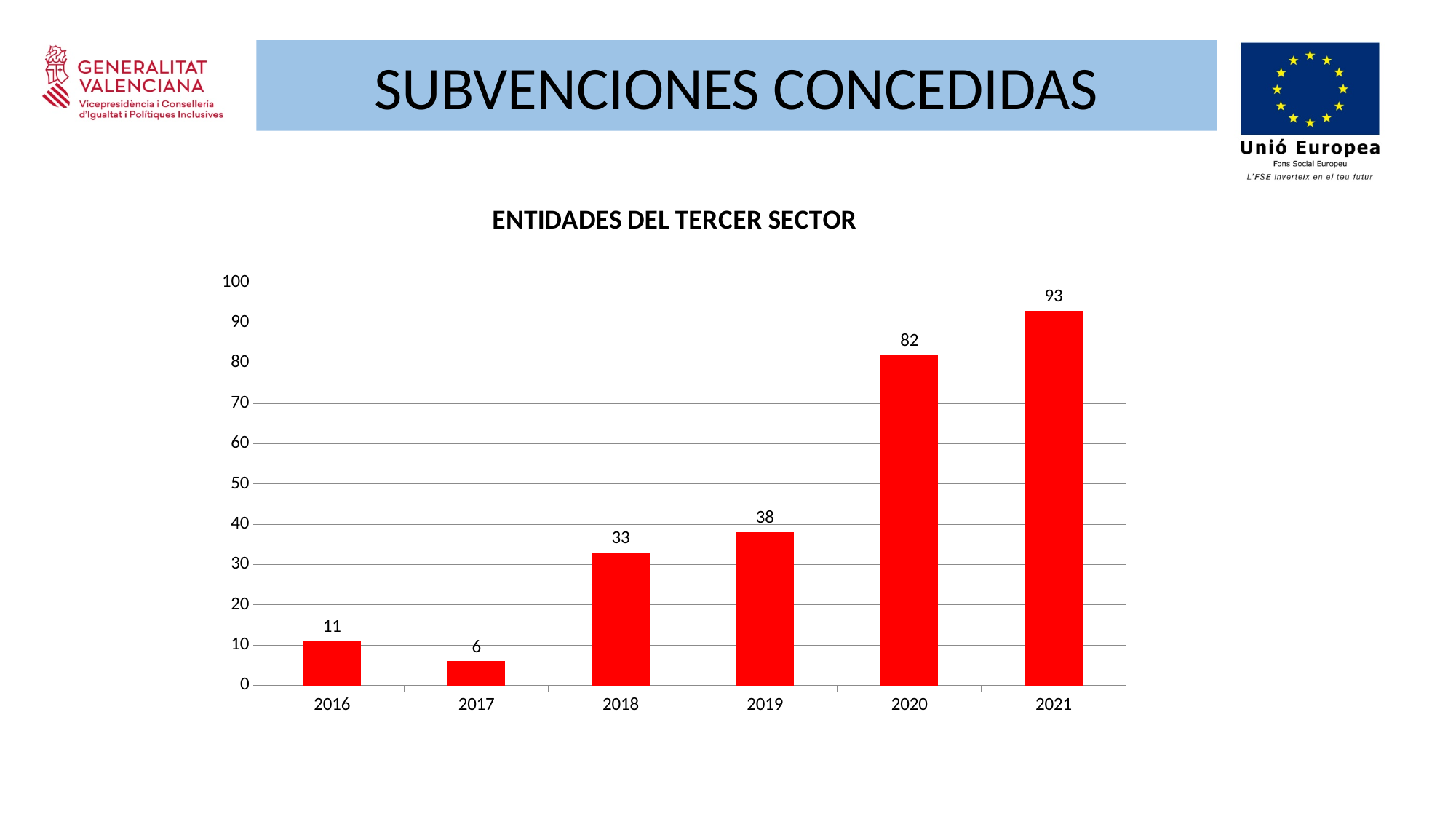
Which year has the lowest value? 2017 What kind of chart is shown on the slide? bar chart Which is larger, the value for 2018 or the value for 2019? 2019 What is the title of the chart? ENTIDADES DEL TERCER SECTOR What is the value for 2019? 38 Is the value for 2020 greater or less than 70? greater What is the value for 2021? 93 Which year has the highest value? 2021 How many years are shown on the x axis? 6 What is the difference between the values for 2018 and 2017? 27 What is the value for 2016? 11 What is the difference between the values for 2020 and 2019? 44